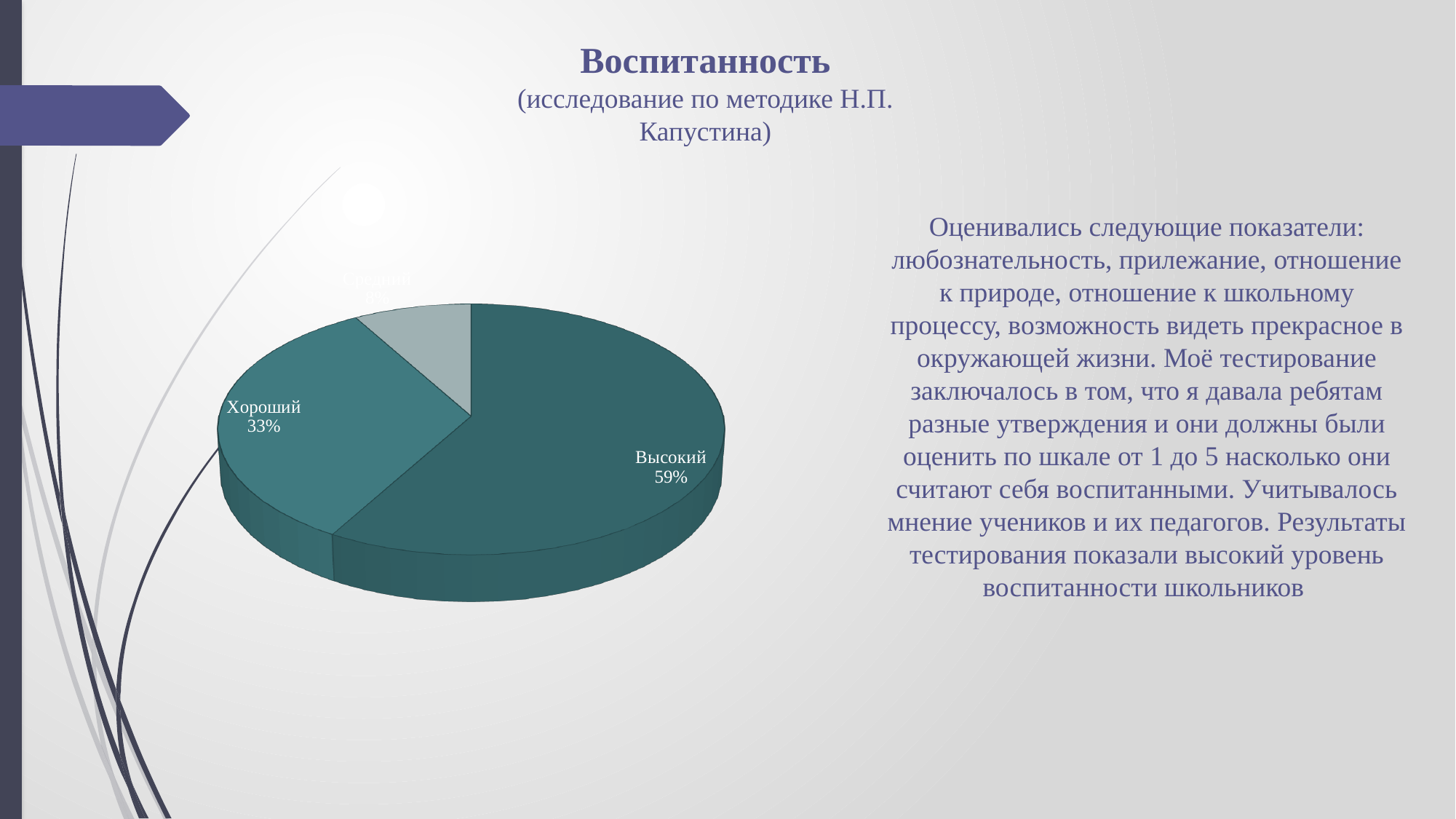
Which category has the smallest slice of the pie? Средний What kind of chart is shown on the slide? pie chart Whose methodology is named in the chart's subtitle? Н.П. Капустина How many slices does the pie chart have? 3 Which slice is larger, "Хороший" or "Средний"? Хороший What is the bold title above the chart? Воспитанность What share of the pie does the "Высокий" slice represent? 59% What is the difference in percentage points between the "Высокий" and "Хороший" slices? 26 What share of the pie does the "Хороший" slice represent? 33% Which category has the largest slice of the pie? Высокий What share of the pie does the "Средний" slice represent? 8% What is the combined share of the "Высокий" and "Хороший" slices? 92%